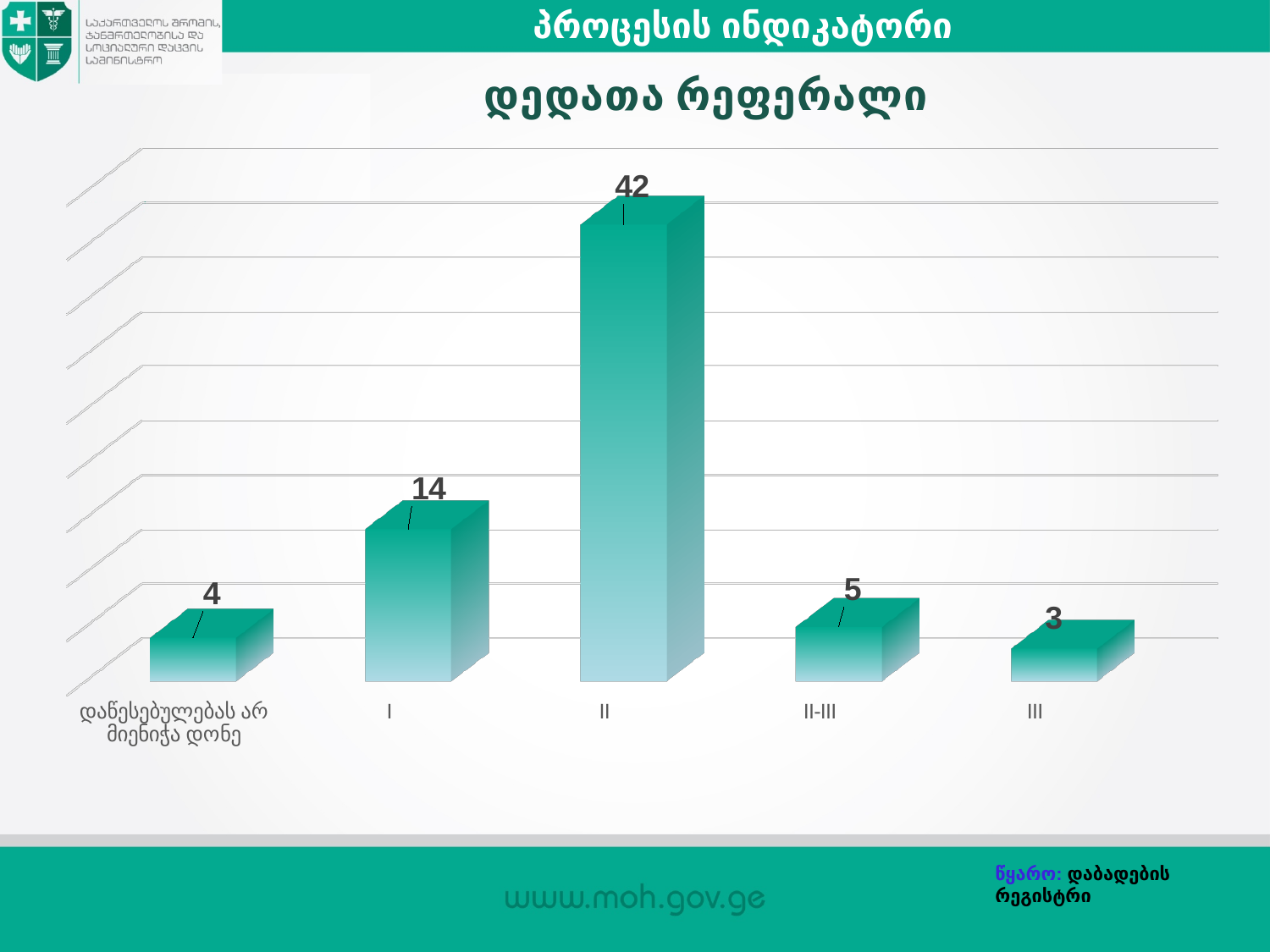
What is the value for category I? 14 What type of chart is shown on the slide? Bar chart Which is larger, the value for category I or the value for category II-III? I What is the value for category II-III? 5 How many categories are shown on the chart? 5 What is the value for the category "დაწესებულებას არ მიენიჭა დონე"? 4 What is the difference between the values for category II and category I? 28 What is the value for category II? 42 What is the value for category III? 3 Which category has the lowest value? III What is the difference between the values for category II-III and category III? 2 Which category has the highest value? II